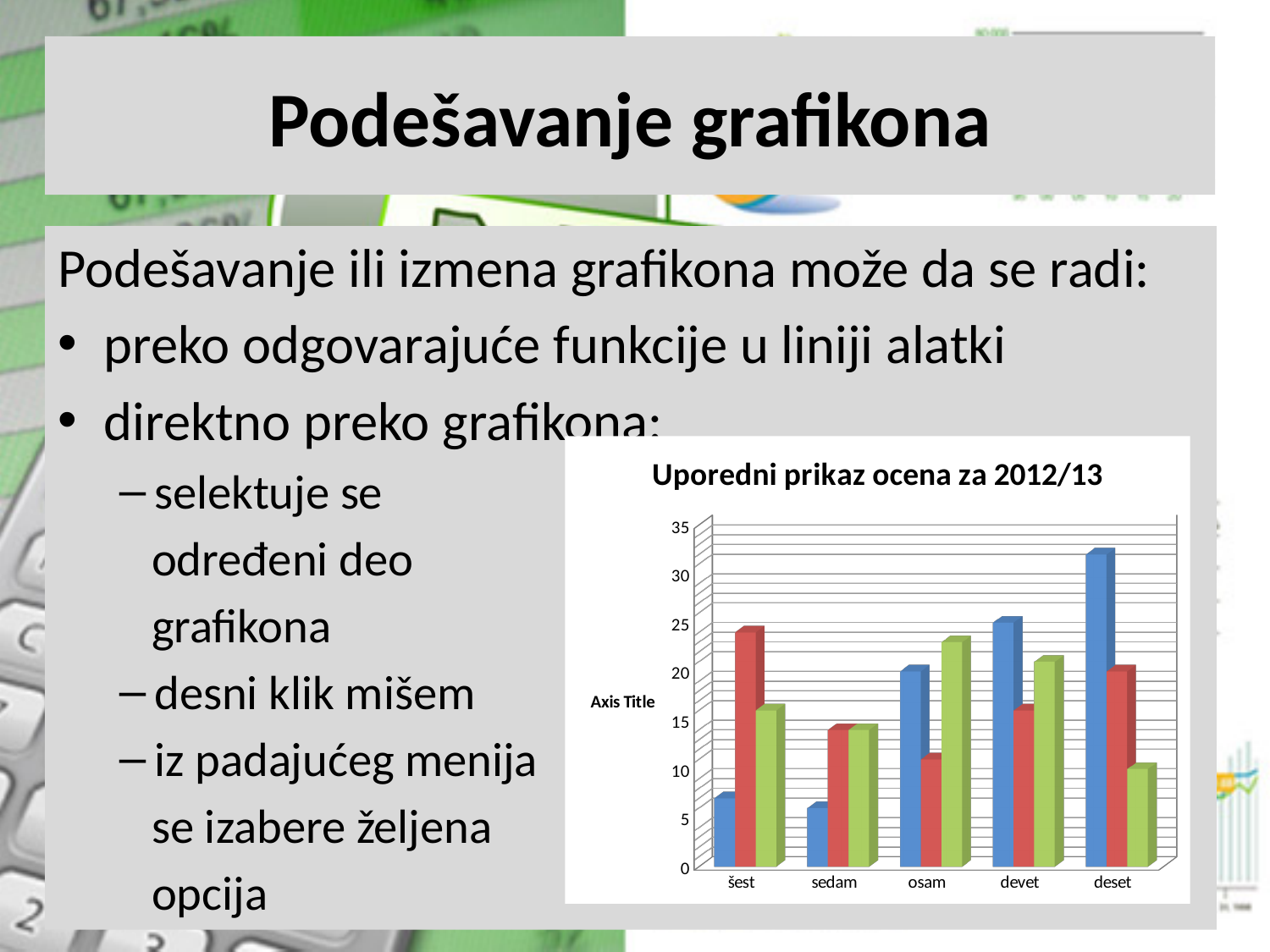
What type of chart is shown on the slide? bar chart Which is larger in the chart: the blue bar for osam or the blue bar for sedam? osam Which category has the shortest green bar in the chart? deset How many bars are plotted for each category in the chart? 3 Which category has the shortest blue bar in the chart? sedam Is the red bar for šest greater or less than 20? greater Which category has the tallest blue bar in the chart? deset How many categories are shown on the x axis of the chart? 5 What is the title of the chart on the slide? Uporedni prikaz ocena za 2012/13 Is the blue bar for šest greater or less than 10? less Is the blue bar for deset greater or less than 30? greater Which category has the tallest red bar in the chart? šest